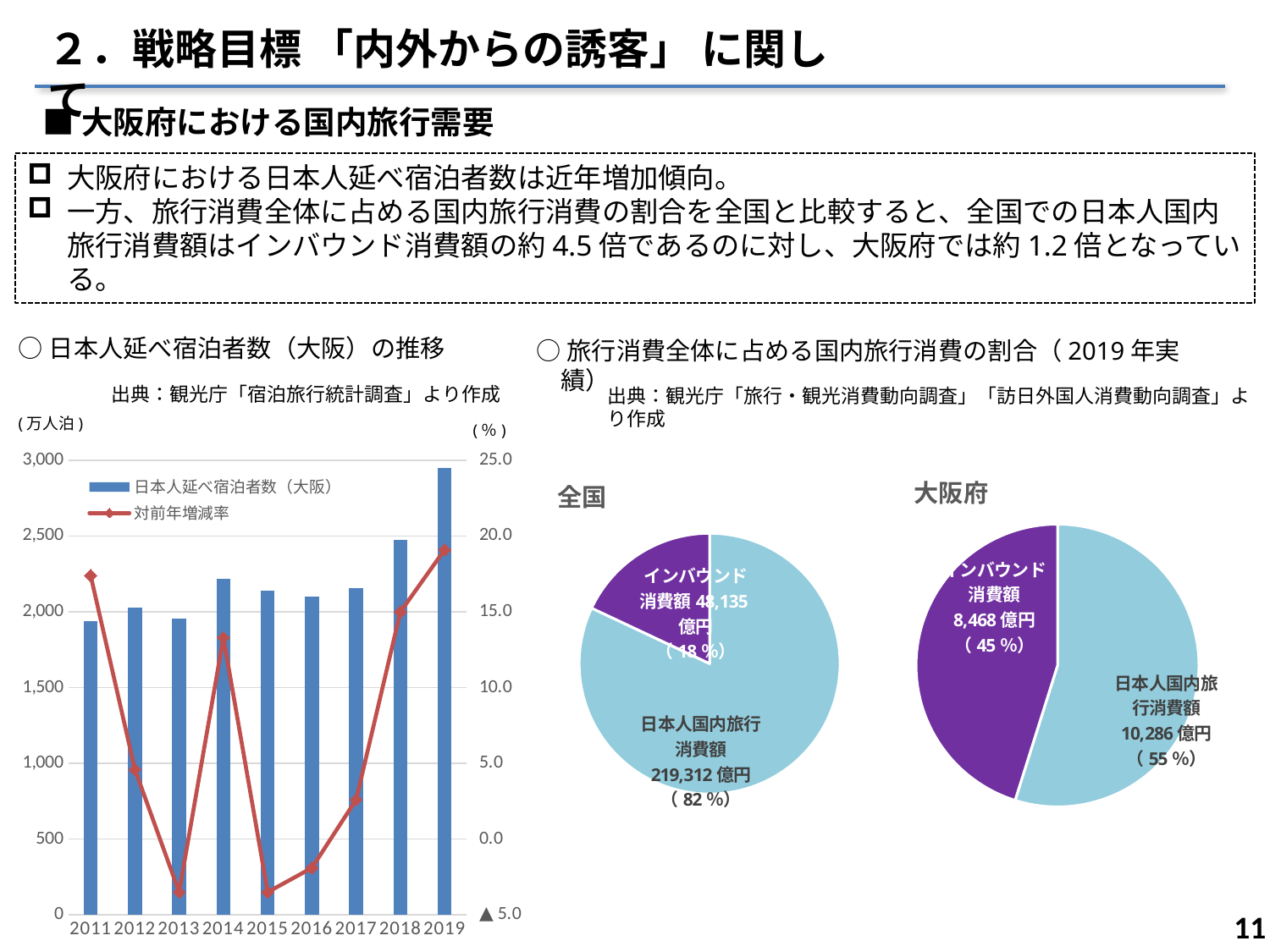
In the 全国 pie chart, what share of the pie is インバウンド消費額? 18% In the 大阪府 pie chart, what share of the pie is 日本人国内旅行消費額? 55% What kind of chart is the 日本人延べ宿泊者数（大阪）の推移 chart on the left? A bar chart combined with a line chart In the 日本人延べ宿泊者数（大阪）の推移 chart, is the 対前年増減率 value for 2013 greater or less than 0.0? less In the 大阪府 pie chart, what is the difference between 日本人国内旅行消費額 and インバウンド消費額? 1,818 億円 In the 日本人延べ宿泊者数（大阪）の推移 chart, is the bar value for 2019 greater or less than 2,500? greater In the 全国 pie chart, what is the value shown for 日本人国内旅行消費額? 219,312 億円 How many years are shown on the x axis of the 日本人延べ宿泊者数（大阪）の推移 chart? 9 How many series does the legend of the 日本人延べ宿泊者数（大阪）の推移 chart list? 2 In the 大阪府 pie chart, what is the value shown for インバウンド消費額? 8,468 億円 In the 全国 pie chart, which is larger, 日本人国内旅行消費額 or インバウンド消費額? 日本人国内旅行消費額 In the 日本人延べ宿泊者数（大阪）の推移 chart, which year has the highest 日本人延べ宿泊者数 bar? 2019